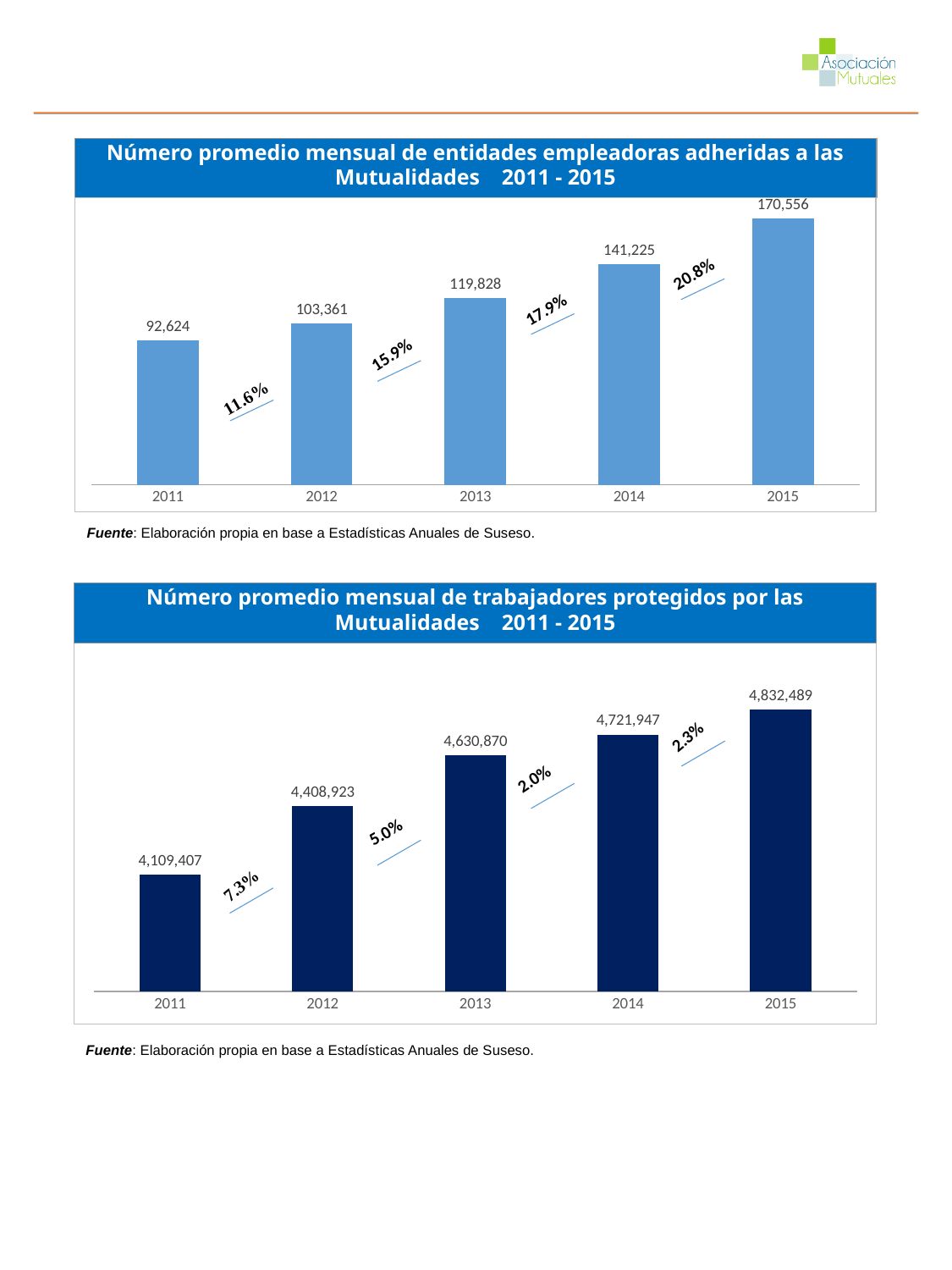
In the top chart (entidades empleadoras adheridas), what is the difference between the 2015 and 2011 values? 77,932 In the bottom chart (trabajadores protegidos), which year has the highest value? 2015 In the top chart (entidades empleadoras adheridas), what is the value for 2015? 170,556 In the bottom chart (trabajadores protegidos), what is the difference between the 2015 and 2014 values? 110,542 In the top chart (entidades empleadoras adheridas), how many years are plotted? 5 In the top chart (entidades empleadoras adheridas), what percentage growth is shown between 2014 and 2015? 20.8% What type of chart is the bottom chart (trabajadores protegidos)? bar chart In the top chart (entidades empleadoras adheridas), which year has the lowest value? 2011 In the bottom chart (trabajadores protegidos), what percentage growth is shown between 2011 and 2012? 7.3% In the top chart (entidades empleadoras adheridas), what is the value for 2013? 119,828 In the bottom chart (trabajadores protegidos), what is the value for 2012? 4,408,923 In the bottom chart (trabajadores protegidos), do the values rise or fall from 2011 to 2015? rise